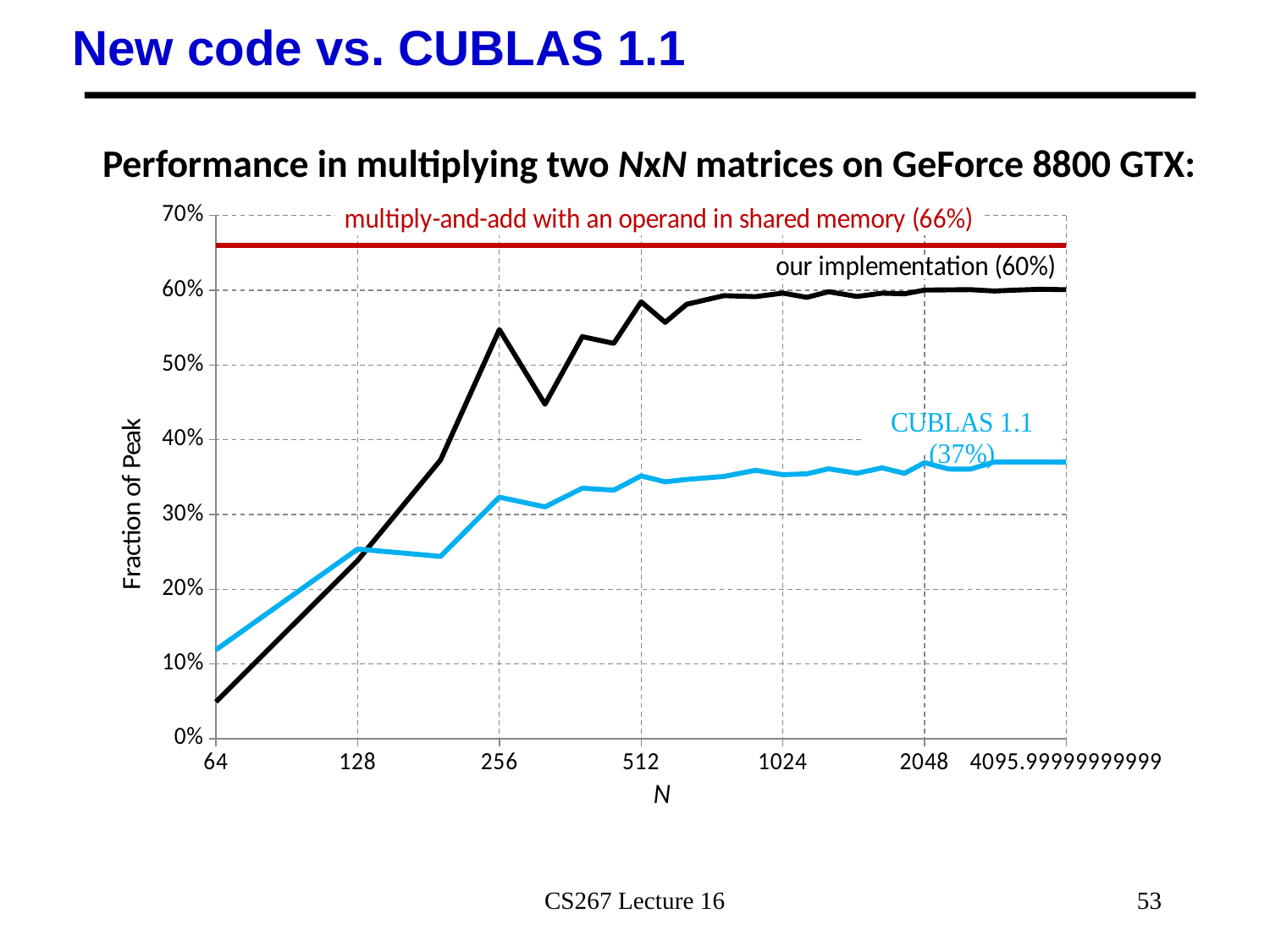
Does the CUBLAS 1.1 line generally rise or fall as N increases from 64 to 4096? rise At N = 2048, is the value for CUBLAS 1.1 greater or less than 40%? less What is the label of the x axis? N What percentage is printed in the annotation for 'our implementation'? 60% Which of the two plotted implementations reaches a higher fraction of peak at N = 4096: our implementation or CUBLAS 1.1? our implementation What percentage is printed in the annotation for 'multiply-and-add with an operand in shared memory'? 66% At N = 1024, is the value for our implementation greater or less than 50%? greater What percentage is printed in the annotation for CUBLAS 1.1? 37% What is the label of the y axis? Fraction of Peak What kind of chart is shown on the slide? line chart At N = 128, which line is higher: our implementation or CUBLAS 1.1? CUBLAS 1.1 At N = 64, is the value for our implementation greater or less than 10%? less